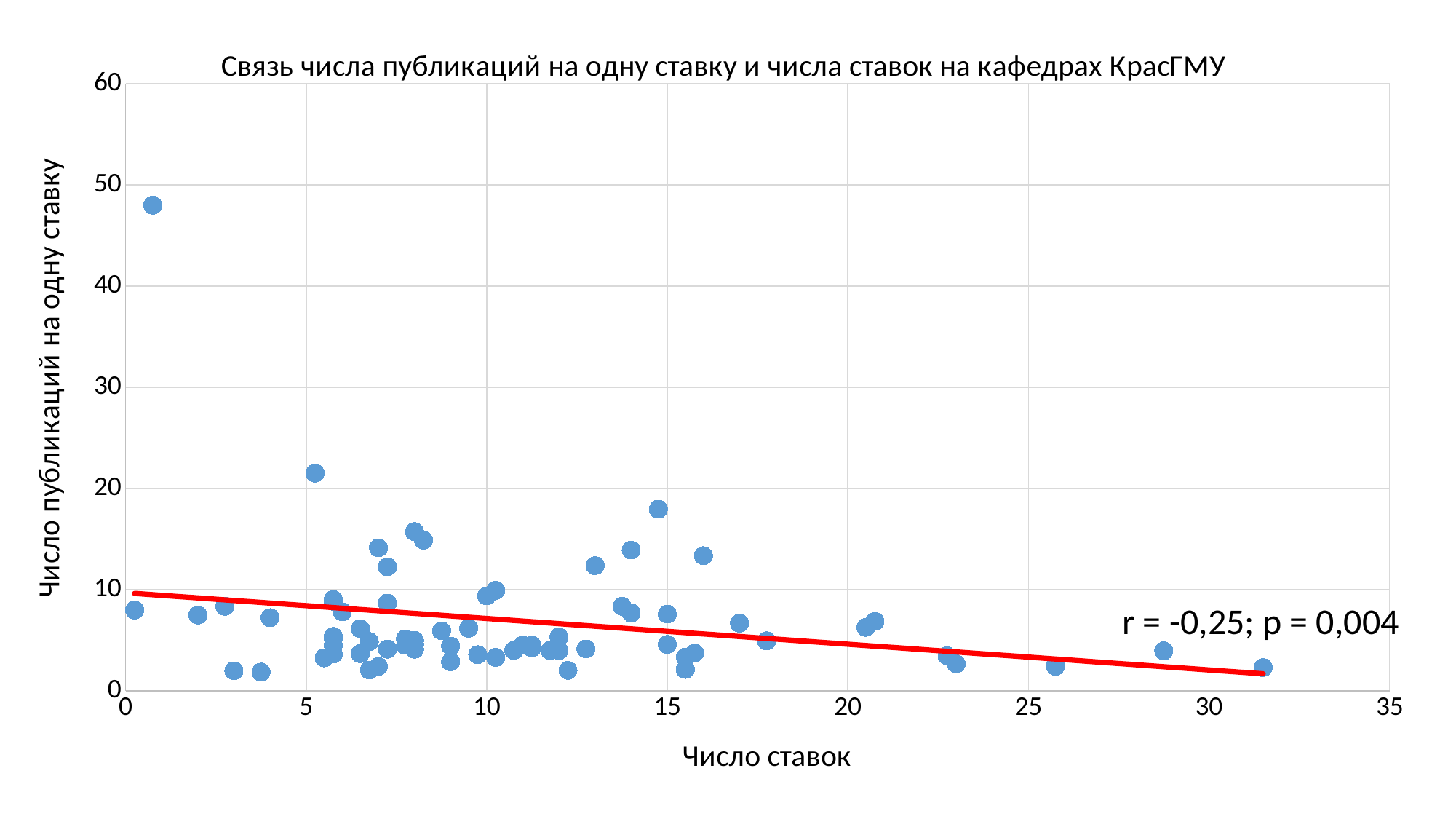
What p-value is printed on the chart? 0,004 What kind of chart is shown on the slide? scatter chart Is the y-value of the highest point near x = 15 greater or less than 15? greater Is the relationship shown by the trend line positive or negative? negative What is the title of the chart? Связь числа публикаций на одну ставку и числа ставок на кафедрах КрасГМУ Does the red trend line rise or fall as the number of positions (Число ставок) increases? fall What is the value of the correlation coefficient r printed on the chart? -0,25 What is the title of the x axis? Число ставок Is the y-value of the highest point on the chart greater or less than 40? greater Is the y-value of the rightmost point (near x = 31.5) greater or less than 10? less Does the point with the highest number of publications per position lie to the left or to the right of x = 5? left